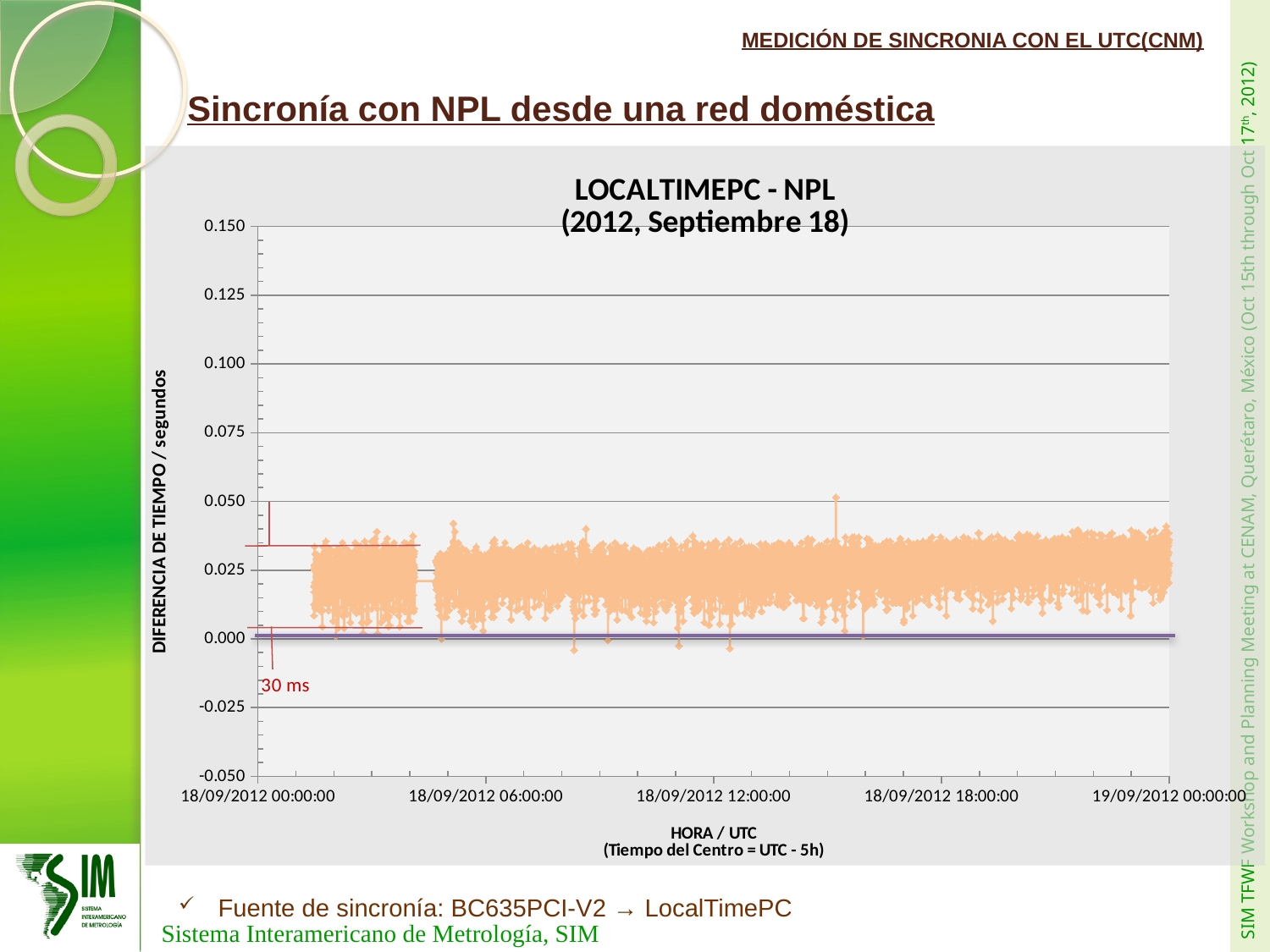
How many labelled tick marks are there on the horizontal axis of the chart? 5 What is the lowest value shown on the vertical axis of the chart? -0.050 Are the plotted time-difference values mostly greater or less than 0.050 seconds? less What is the first date-time label on the horizontal axis of the chart? 18/09/2012 00:00:00 What value does the red annotation near the left of the chart indicate? 30 ms What kind of chart is shown on the slide? scatter chart What is the highest value shown on the vertical axis of the chart? 0.150 Do the plotted values show a clear rising or falling trend across the day, or do they stay roughly level? roughly level Are the plotted time-difference values mostly greater or less than 0.000 seconds? greater What is the title of the chart? LOCALTIMEPC - NPL (2012, Septiembre 18) What is the last date-time label on the horizontal axis of the chart? 19/09/2012 00:00:00 What is the label of the vertical axis of the chart? DIFERENCIA DE TIEMPO / segundos